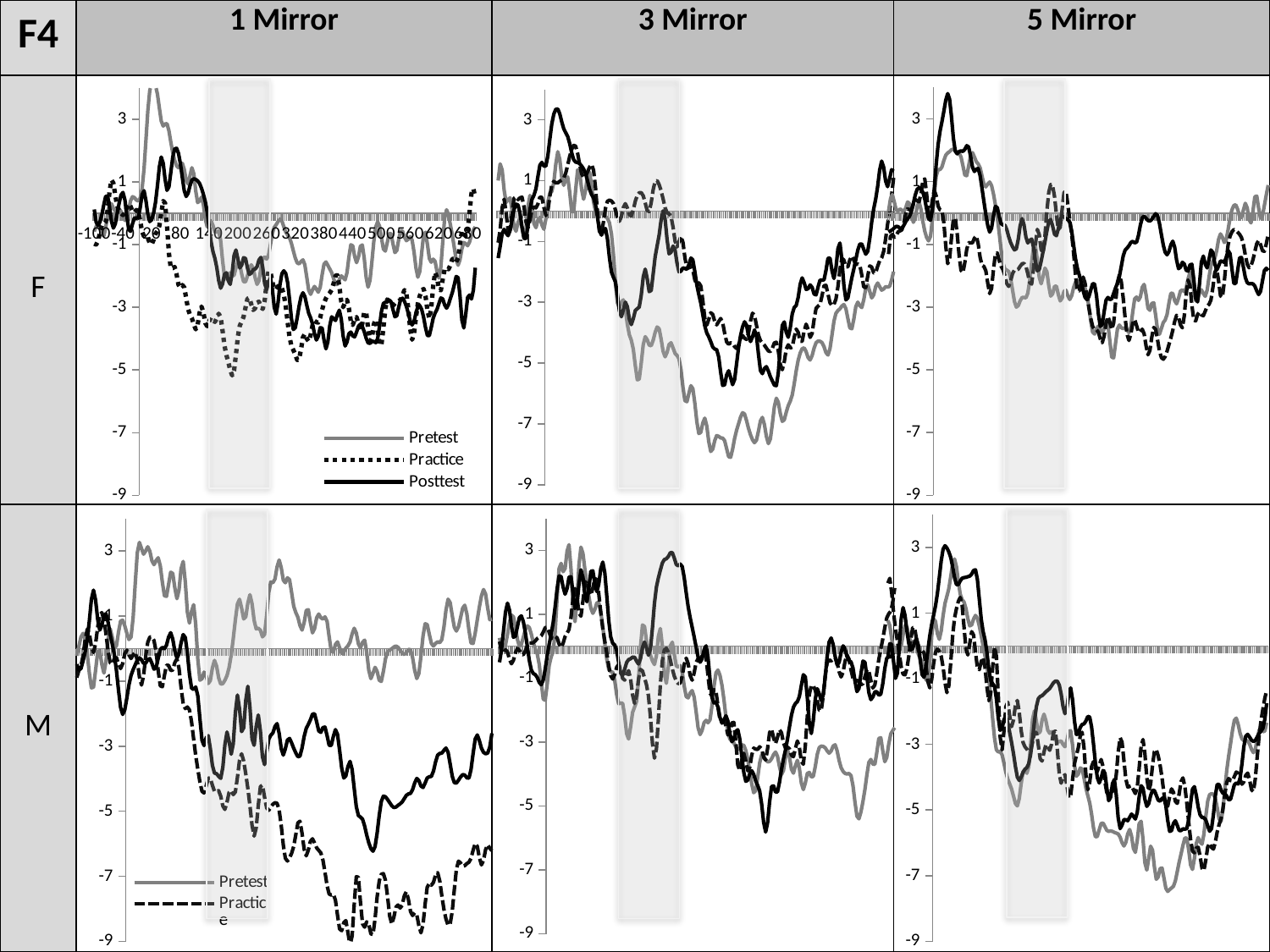
In the F / 5 Mirror chart, is the peak value of the Posttest line greater or less than 3? greater How many series does the legend in the F / 1 Mirror chart list? 3 In the F / 3 Mirror chart, is the lowest value of the Pretest line greater or less than -7? less In the M / 1 Mirror chart, which line stays highest over most of the time window, Pretest or Practice? Pretest In the F / 1 Mirror chart, which series is drawn as a dotted line? Practice In the F / 3 Mirror chart, which line reaches the lower minimum, Pretest or Posttest? Pretest In the M / 1 Mirror chart, is the lowest value of the Practice line greater or less than -7? less How many charts are shown on the slide? 6 What kind of chart is used in each panel of the F4 grid? line chart What are the three series named in the legend of the F / 1 Mirror chart? Pretest, Practice, Posttest